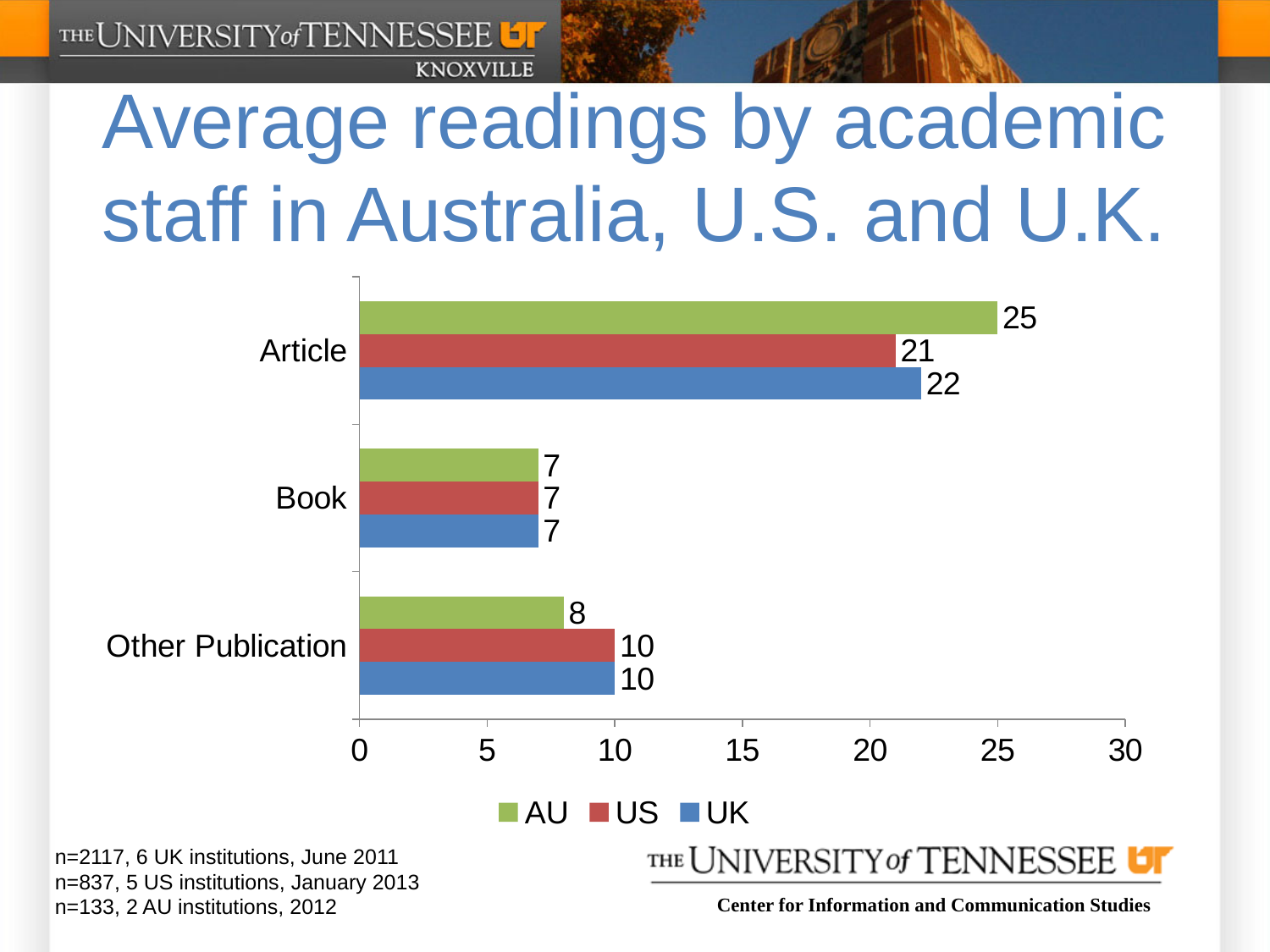
What is the average number of article readings for US? 21 What is the difference between AU and US average article readings? 4 Which country has the highest average article readings? AU How many series does the legend list? 3 Which is larger, the UK value for Article or the US value for Article? UK What is the average number of book readings for AU? 7 What is the average number of article readings for AU? 25 How many publication categories are shown on the chart? 3 What kind of chart is shown on the slide? Bar chart Which country has the lowest average Other Publication readings? AU What is the average number of Other Publication readings for UK? 10 Is the AU value for Article greater or less than 20? greater